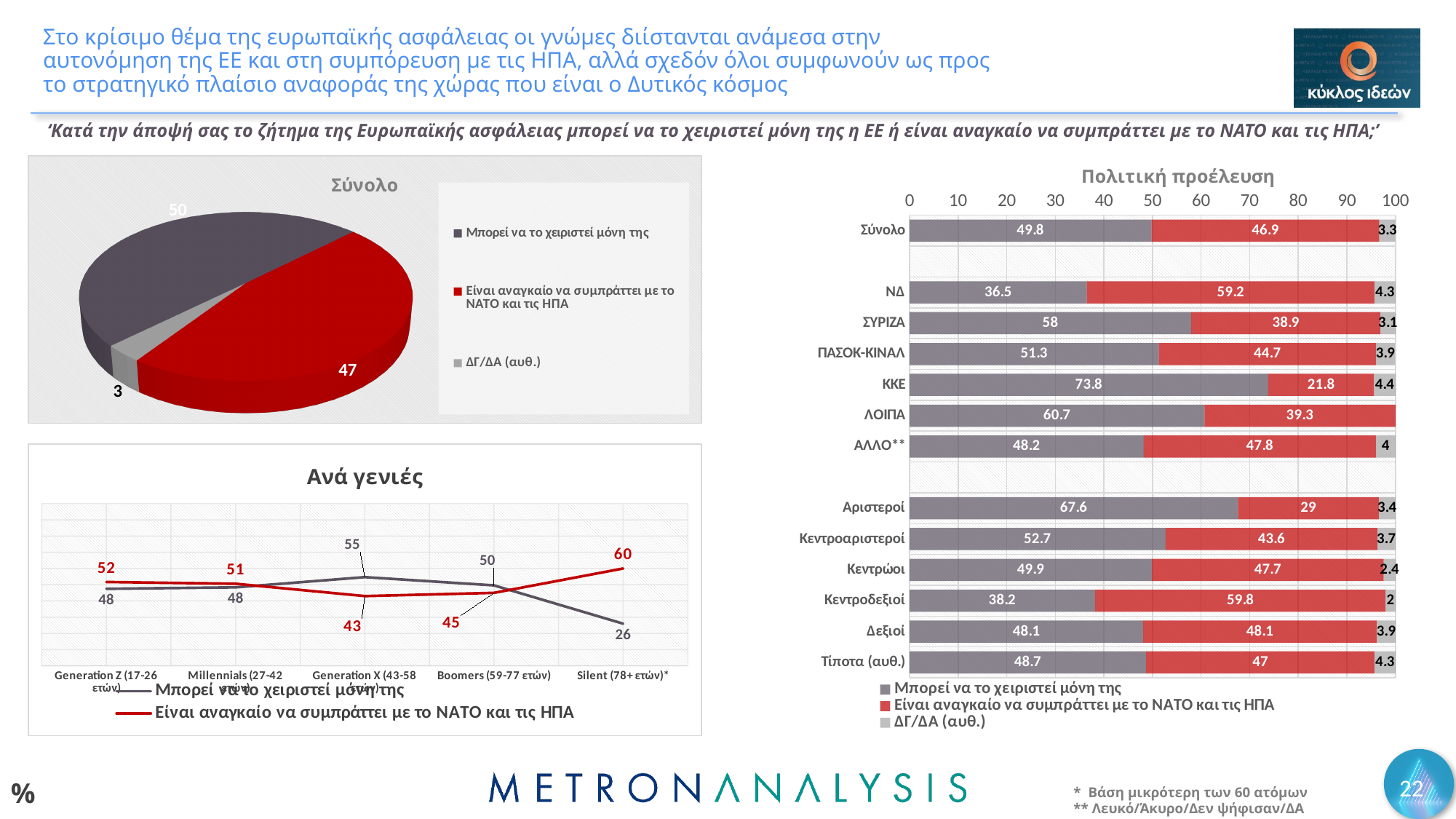
What kind of chart is the chart titled 'Σύνολο'? Pie chart In the pie chart titled 'Σύνολο', what is the value for 'Μπορεί να το χειριστεί μόνη της'? 50 In the chart titled 'Ανά γενιές', which generation has the highest value for 'Μπορεί να το χειριστεί μόνη της'? Generation X (43-58 ετών) In the chart titled 'Πολιτική προέλευση', which category has the highest value for 'Μπορεί να το χειριστεί μόνη της'? ΚΚΕ In the chart titled 'Πολιτική προέλευση', which has the larger value for 'Είναι αναγκαίο να συμπράττει με το ΝΑΤΟ και τις ΗΠΑ', ΝΔ or ΣΥΡΙΖΑ? ΝΔ In the chart titled 'Πολιτική προέλευση', what is the 'ΔΓ/ΔΑ (αυθ.)' value for Κεντροδεξιοί? 2 In the chart titled 'Πολιτική προέλευση', what is the difference between the ΝΔ values for 'Είναι αναγκαίο να συμπράττει με το ΝΑΤΟ και τις ΗΠΑ' and 'Μπορεί να το χειριστεί μόνη της'? 22.7 In the chart titled 'Ανά γενιές', what is the difference between the two series' values for 'Silent (78+ ετών)*'? 34 How many generation categories are shown on the x axis of the chart titled 'Ανά γενιές'? 5 In the chart titled 'Ανά γενιές', what is the value for 'Silent (78+ ετών)*' in the series 'Είναι αναγκαίο να συμπράττει με το ΝΑΤΟ και τις ΗΠΑ'? 60 How many series does the legend of the chart titled 'Πολιτική προέλευση' list? 3 In the chart titled 'Πολιτική προέλευση', what is the value for ΚΚΕ in the series 'Μπορεί να το χειριστεί μόνη της'? 73.8